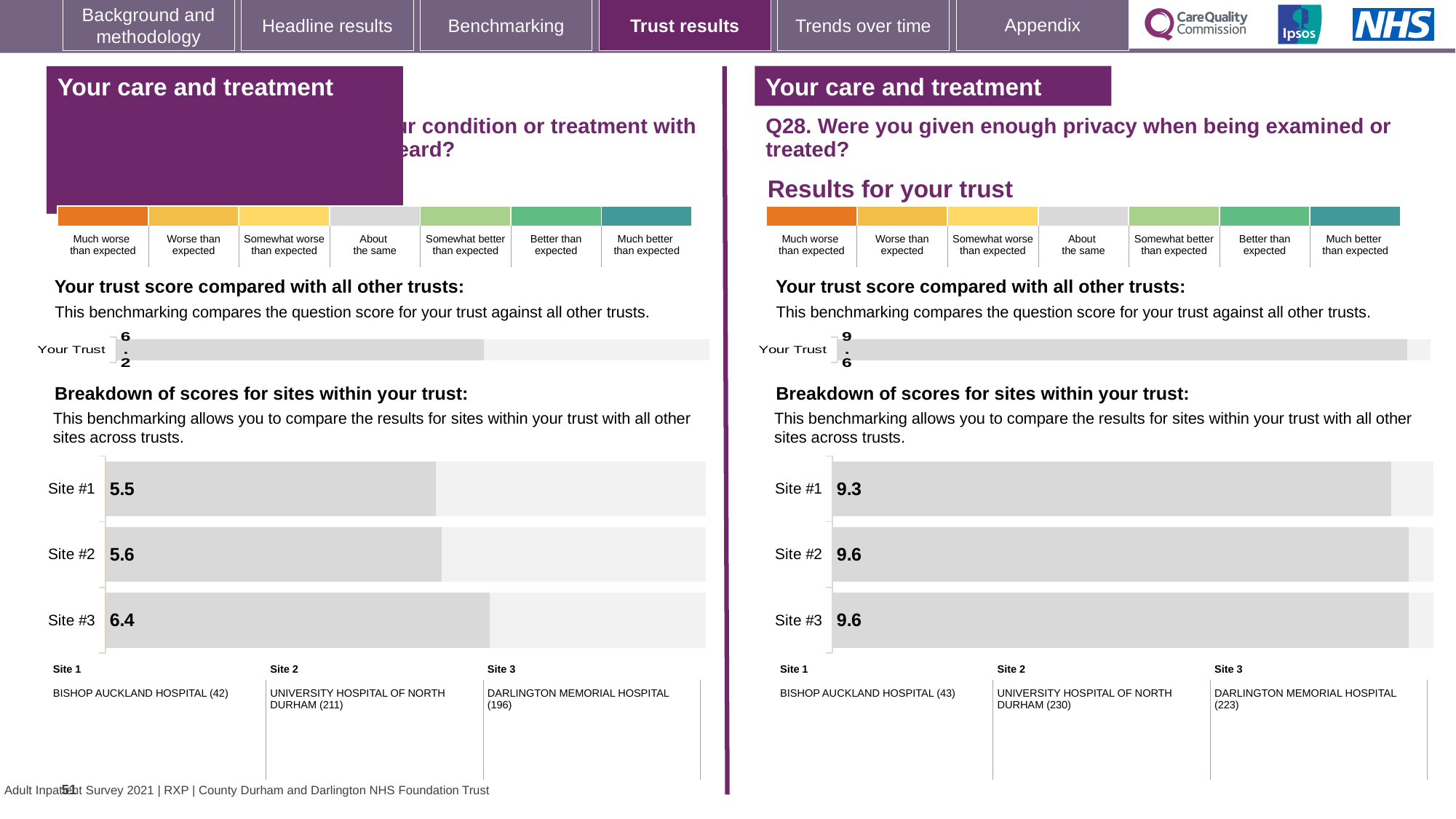
On the Q28 chart on the right, what is the 'Your Trust' score? 9.6 On the Q28 chart on the right, what is the score for Site #1? 9.3 On the left-hand chart, what is the 'Your Trust' score? 6.2 On the Q28 chart on the right, which site has the lowest score? Site #1 On the left-hand chart, what is the difference between the scores for Site #3 and Site #1? 0.9 On the Q28 chart on the right, what is the score for Site #2? 9.6 On the left-hand chart, what is the score for Site #1? 5.5 On the left-hand chart, which site has the highest score? Site #3 How many sites are shown in the site breakdown chart on the right-hand side? 3 What type of chart is used for the breakdown of scores for sites on the left-hand side? Bar chart On the left-hand chart, which site has the lowest score? Site #1 On the left-hand chart, what is the score for Site #3? 6.4